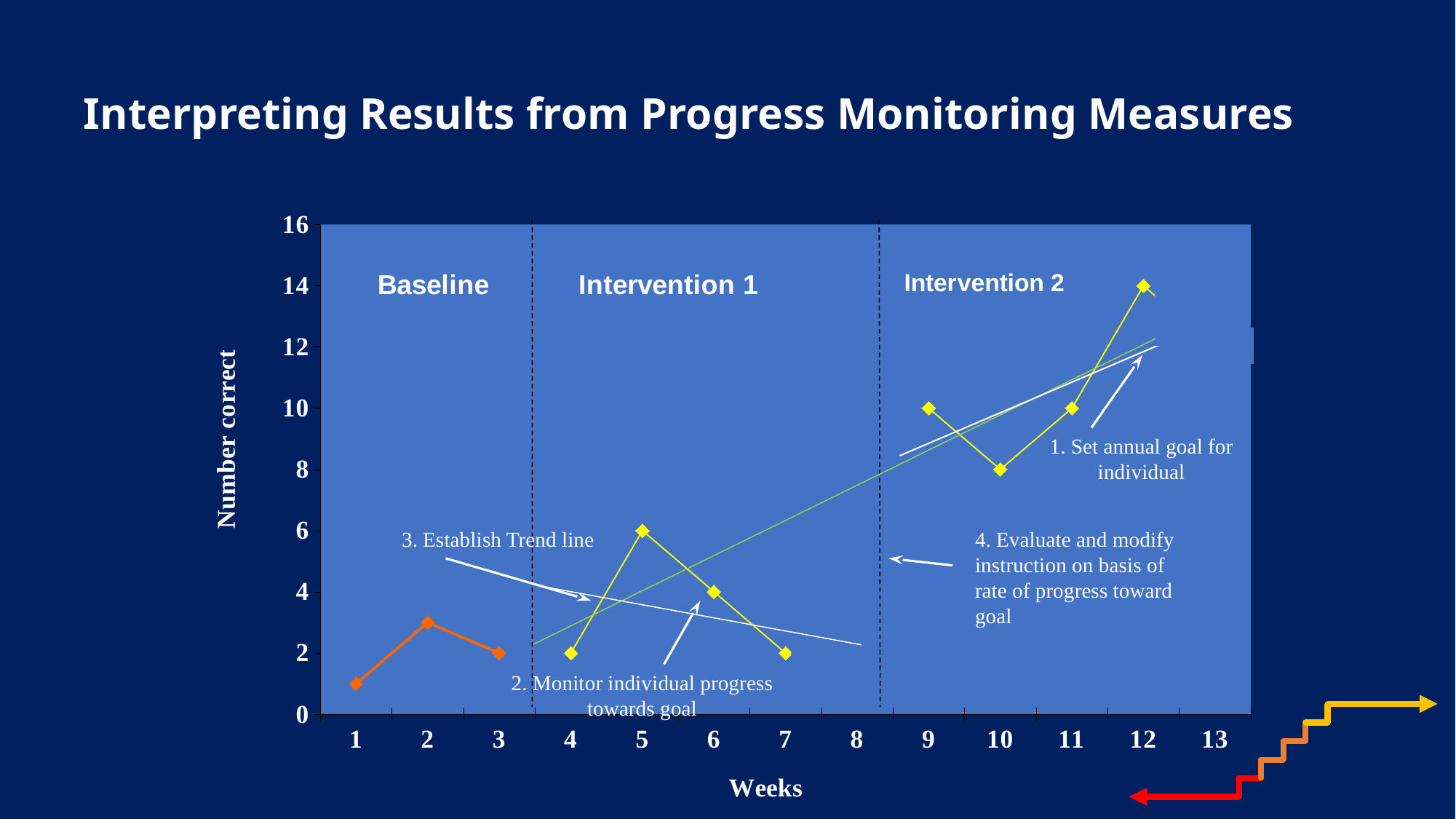
Is the number correct at week 1 greater or less than 2? less At which week is the number correct highest? 12 What kind of chart is shown on the slide? line chart How many phases are labelled on the chart (Baseline, Intervention 1, Intervention 2)? 3 What is the number correct at week 5? 6 Do the values rise or fall from week 5 to week 7? fall What is the label of the x axis? Weeks What is the difference in number correct between week 12 and week 11? 4 What is the number correct at week 7? 2 What is the number correct at week 12? 14 What is the number correct at week 10? 8 Which week has the larger number correct, week 5 or week 7? week 5